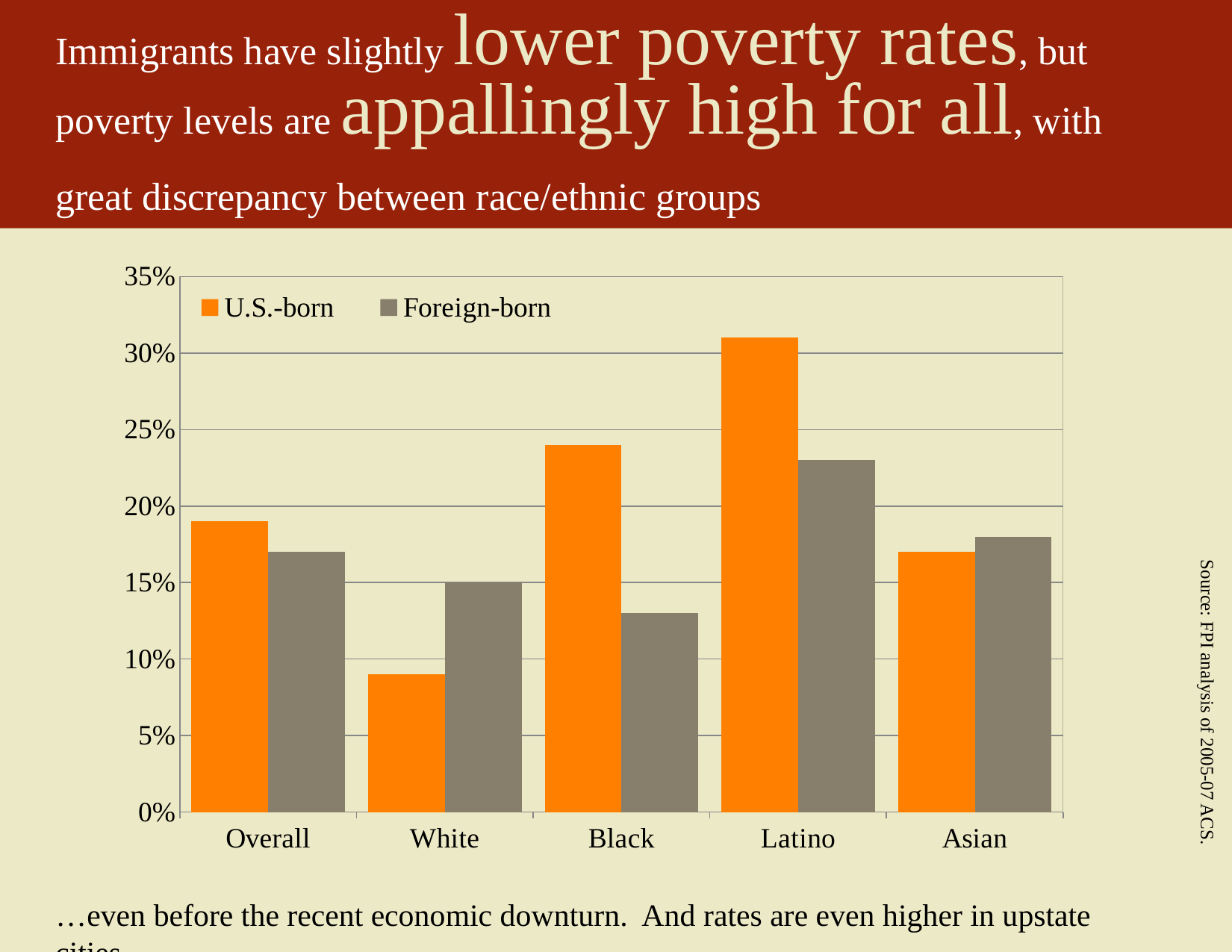
What kind of chart is shown on the slide? bar chart Is the U.S.-born value for Latino greater or less than 25%? greater How many series does the legend list? 2 Which category has the highest U.S.-born poverty rate? Latino How many race/ethnic categories are shown on the x axis? 5 Which category has the lowest U.S.-born poverty rate? White For White, which is larger: the U.S.-born or the Foreign-born poverty rate? Foreign-born Is the Foreign-born value for Black greater or less than 15%? less Which category has the lowest Foreign-born poverty rate? Black Which category has the highest Foreign-born poverty rate? Latino Which colour represents the Foreign-born series in the legend? grey For Black, which is larger: the U.S.-born or the Foreign-born poverty rate? U.S.-born